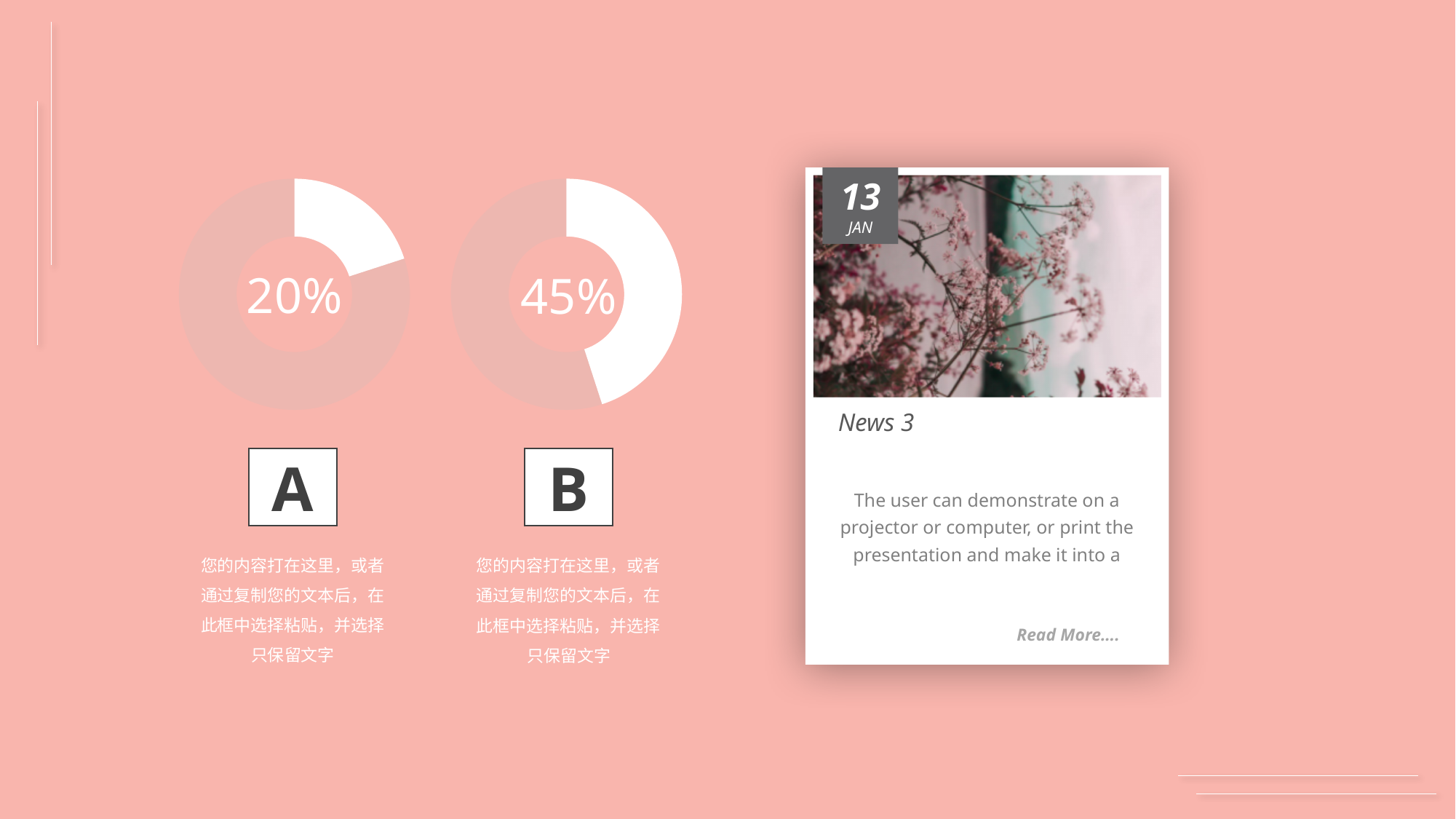
What colour is the filled (highlighted) portion of the donut charts? White What letter labels the donut chart on the left? A How many donut charts are on the slide? 2 Which of the two donut charts, A or B, shows the higher percentage? B Which of the two donut charts, A or B, shows the lower percentage? A What percentage is shown in the centre of donut chart A? 20% What is the difference between the percentages shown in donut chart B and donut chart A? 25% Is the value shown in donut chart A greater or less than 25%? less What kind of chart is used for A and B on the slide? Donut chart What percentage is shown in the centre of donut chart B? 45% Is the value shown in donut chart B greater or less than 50%? less